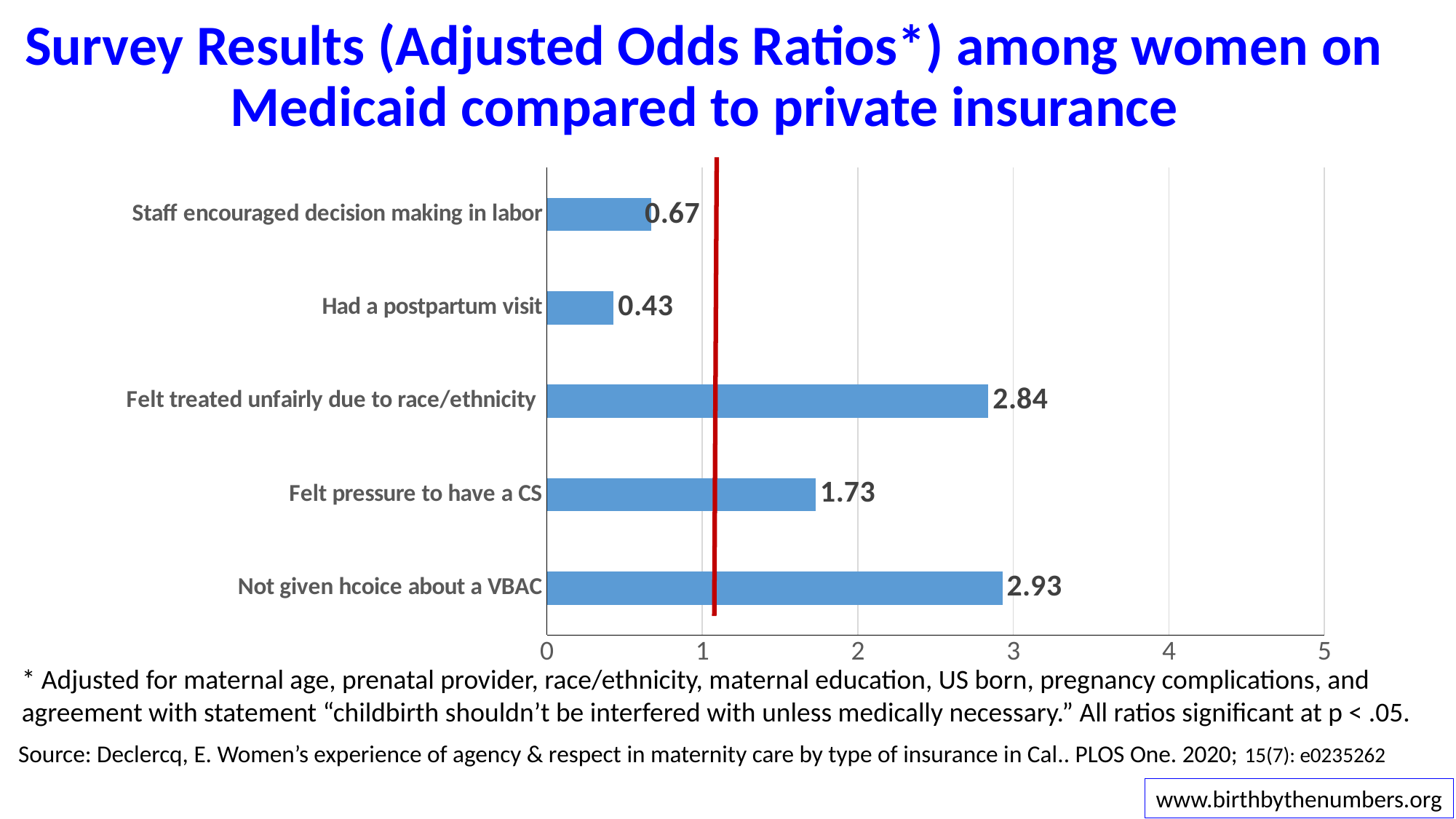
What is the maximum value shown on the horizontal axis? 5 Which is larger: the odds ratio for "Felt pressure to have a CS" or for "Staff encouraged decision making in labor"? Felt pressure to have a CS How many categories are plotted in the chart? 5 What is the adjusted odds ratio for "Staff encouraged decision making in labor"? 0.67 What is the adjusted odds ratio for "Had a postpartum visit"? 0.43 What is the adjusted odds ratio for "Felt pressure to have a CS"? 1.73 What colour are the bars in the chart? Blue What is the difference between the odds ratios for "Felt treated unfairly due to race/ethnicity" and "Felt pressure to have a CS"? 1.11 What kind of chart is shown on the slide? Bar chart Is the value for "Felt treated unfairly due to race/ethnicity" greater or less than 2? greater Which category has the lowest adjusted odds ratio? Had a postpartum visit Which category has the highest adjusted odds ratio? Not given hcoice about a VBAC